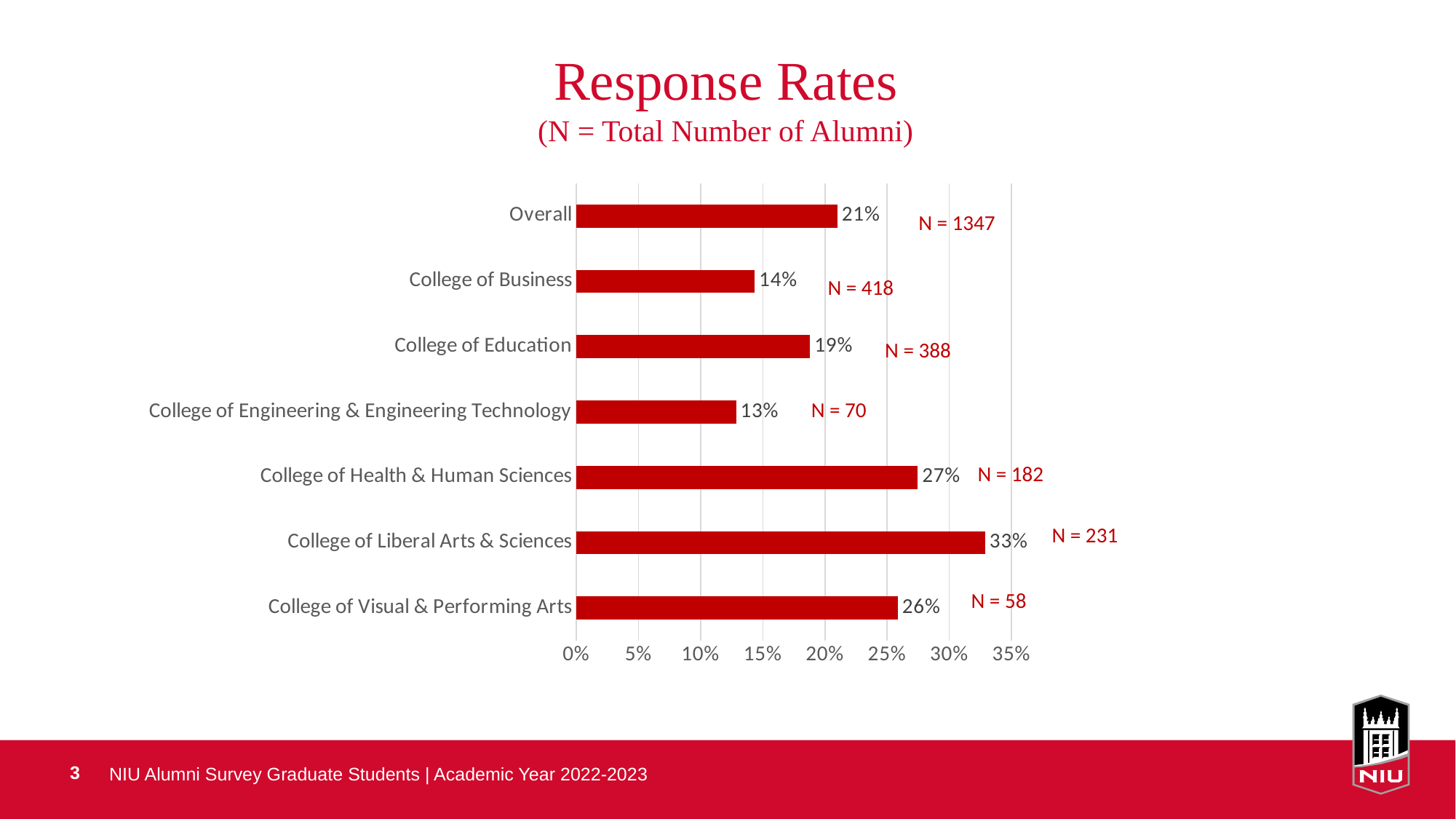
Which category has the highest response rate? College of Liberal Arts & Sciences What is the response rate for the College of Health & Human Sciences? 27% What is the Overall response rate? 21% How many categories are shown in the chart? 7 What is the difference between the response rates of the College of Liberal Arts & Sciences and the College of Education? 14% What is the response rate for the College of Business? 14% What is the total number of alumni (N) for the College of Liberal Arts & Sciences? N = 231 What is the title of the chart? Response Rates What kind of chart is shown on the slide? Bar chart Which category has the lowest response rate? College of Engineering & Engineering Technology Which has a higher response rate, the College of Visual & Performing Arts or the College of Business? College of Visual & Performing Arts Is the response rate for the College of Education greater or less than 15%? greater